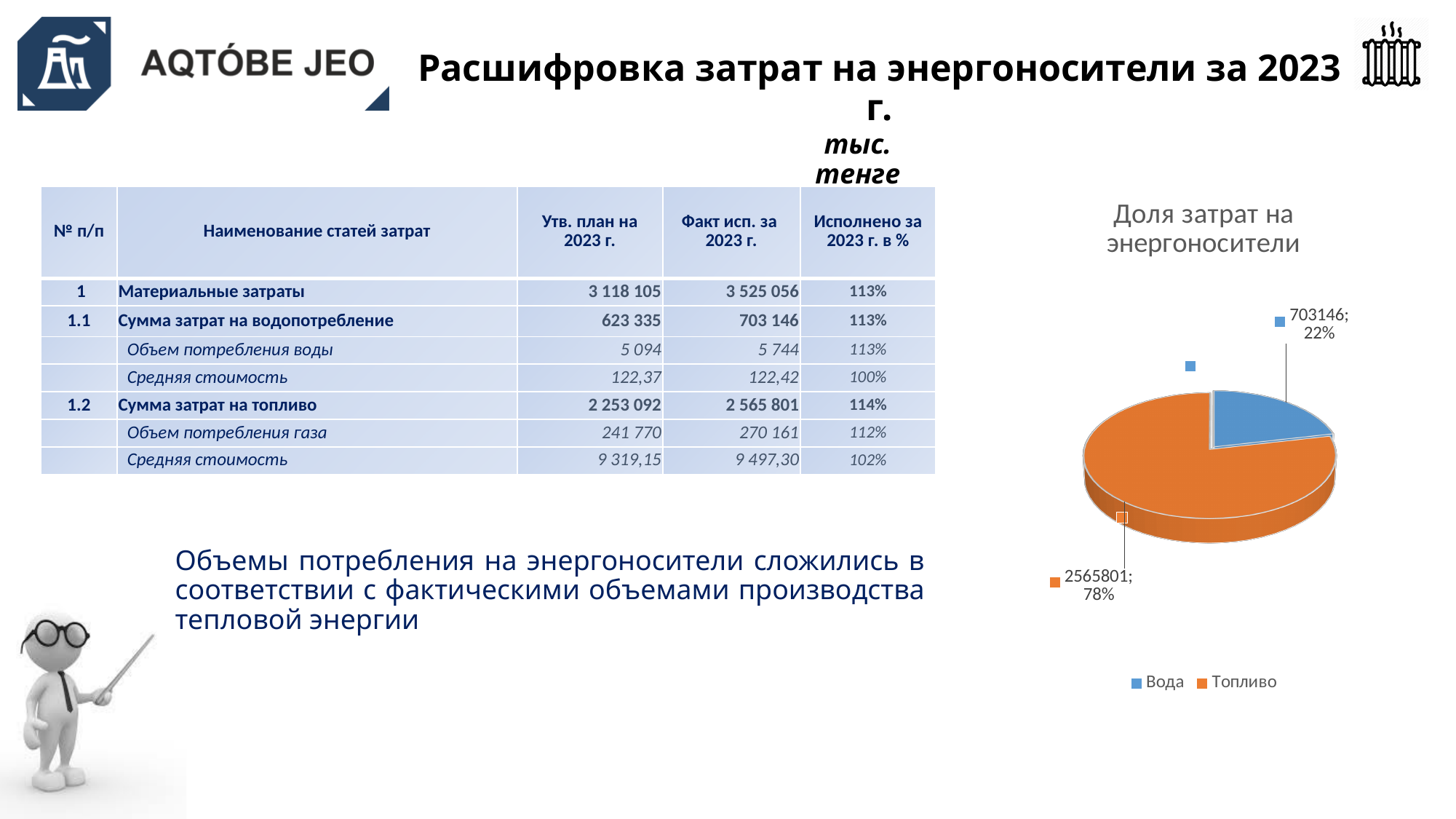
In the pie chart "Доля затрат на энергоносители", which is larger, Вода or Топливо? Топливо In the pie chart "Доля затрат на энергоносители", which category has the smallest slice? Вода In the pie chart "Доля затрат на энергоносители", what value is shown for Топливо? 2565801 In the pie chart "Доля затрат на энергоносители", what is the difference between the values for Топливо and Вода? 1862655 In the pie chart "Доля затрат на энергоносители", what share of the pie does Топливо take? 78% What kind of chart is shown under the title "Доля затрат на энергоносители"? pie chart How many slices does the pie chart "Доля затрат на энергоносители" have? 2 In the pie chart "Доля затрат на энергоносители", what value is shown for Вода? 703146 How many entries does the legend of the pie chart "Доля затрат на энергоносители" list? 2 What is the title of the pie chart on the right side of the slide? Доля затрат на энергоносители In the pie chart "Доля затрат на энергоносители", which category has the largest slice? Топливо In the pie chart "Доля затрат на энергоносители", what share of the pie does Вода take? 22%